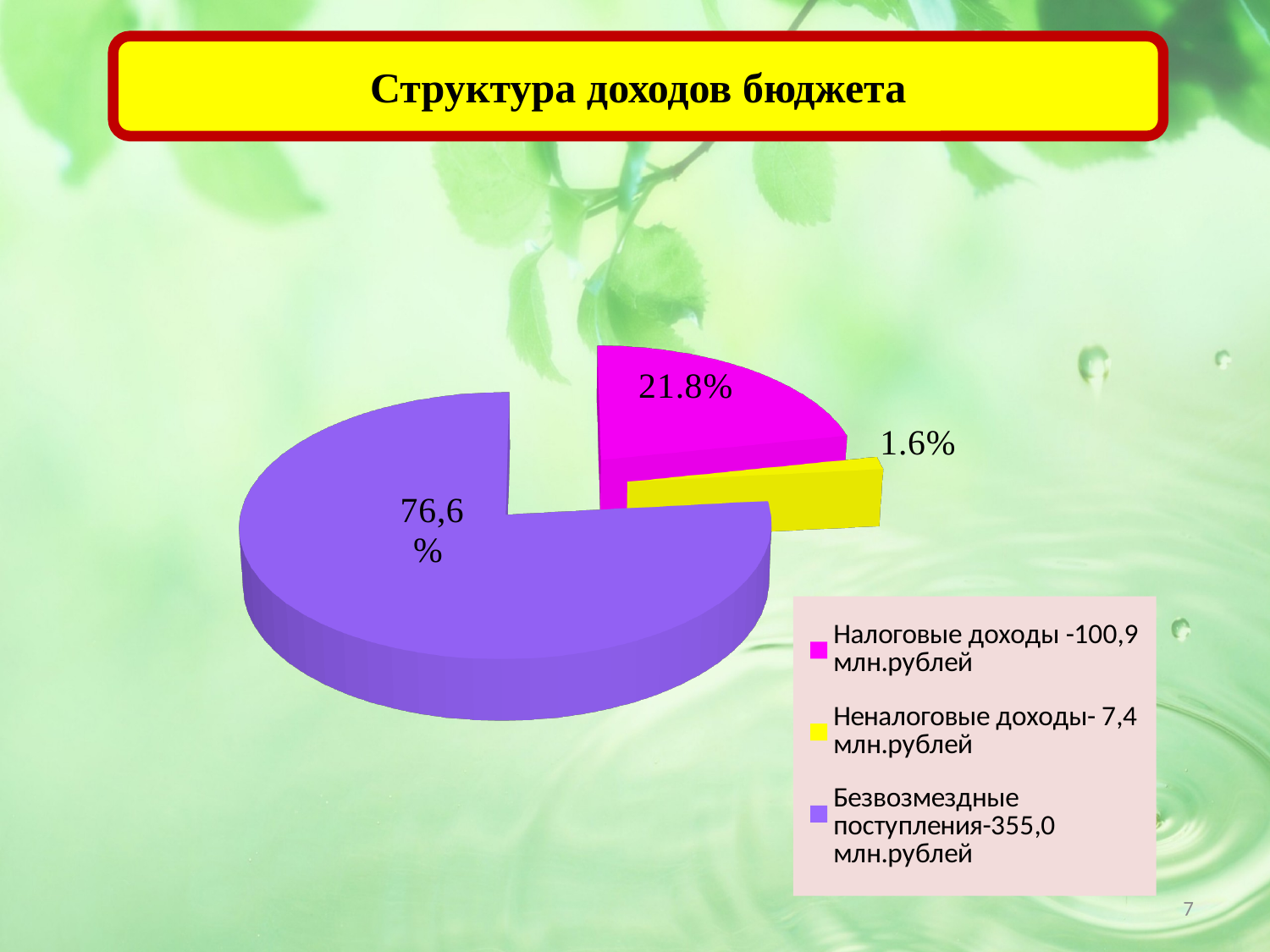
Which is larger: the slice for Налоговые доходы or the slice for Неналоговые доходы? Налоговые доходы Which category has the smallest slice of the pie? Неналоговые доходы According to the legend, what is the amount of Безвозмездные поступления in млн.рублей? 355,0 млн.рублей What share of the pie does Безвозмездные поступления have? 76,6% How many slices does the pie chart have? 3 What share of the pie does Налоговые доходы have? 21.8% According to the legend, what is the amount of Налоговые доходы in млн.рублей? 100,9 млн.рублей What share of the pie does Неналоговые доходы have? 1.6% What kind of chart is shown on the slide? Pie chart What colour is the slice for Неналоговые доходы? Yellow What is the title of the chart on the slide? Структура доходов бюджета Which category has the largest slice of the pie? Безвозмездные поступления